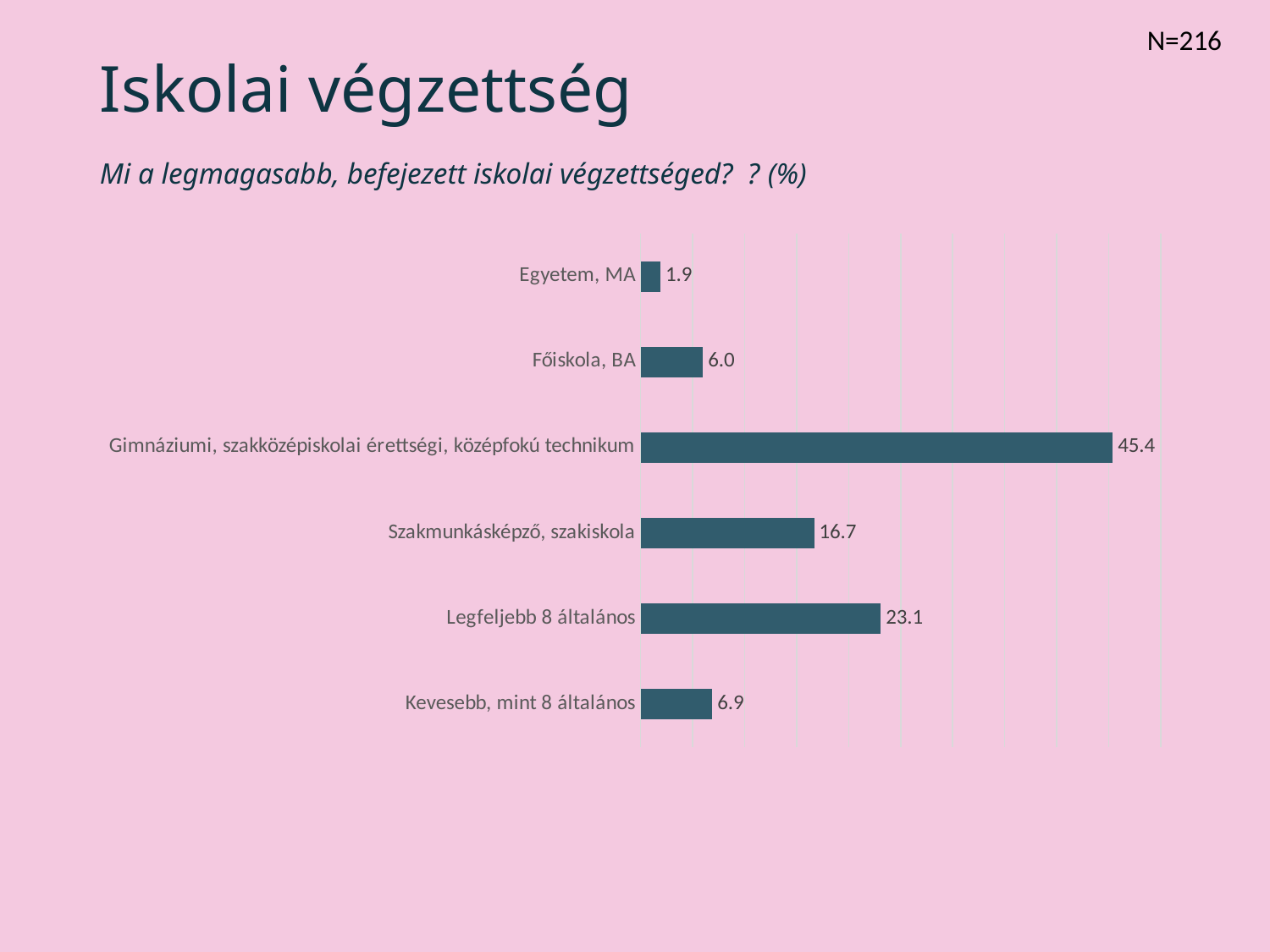
What is the value for "Főiskola, BA"? 6.0 Which category has the lowest value? Egyetem, MA What is the sample size (N) shown on the slide? N=216 What is the value for "Kevesebb, mint 8 általános"? 6.9 What is the value for "Egyetem, MA"? 1.9 What is the difference between the values for "Legfeljebb 8 általános" and "Szakmunkásképző, szakiskola"? 6.4 How many categories are shown in the chart? 6 Which category has the highest value? Gimnáziumi, szakközépiskolai érettségi, középfokú technikum What is the value for "Gimnáziumi, szakközépiskolai érettségi, középfokú technikum"? 45.4 Which is larger: the value for "Kevesebb, mint 8 általános" or the value for "Főiskola, BA"? Kevesebb, mint 8 általános What is the value for "Szakmunkásképző, szakiskola"? 16.7 What kind of chart is shown on the slide? Bar chart